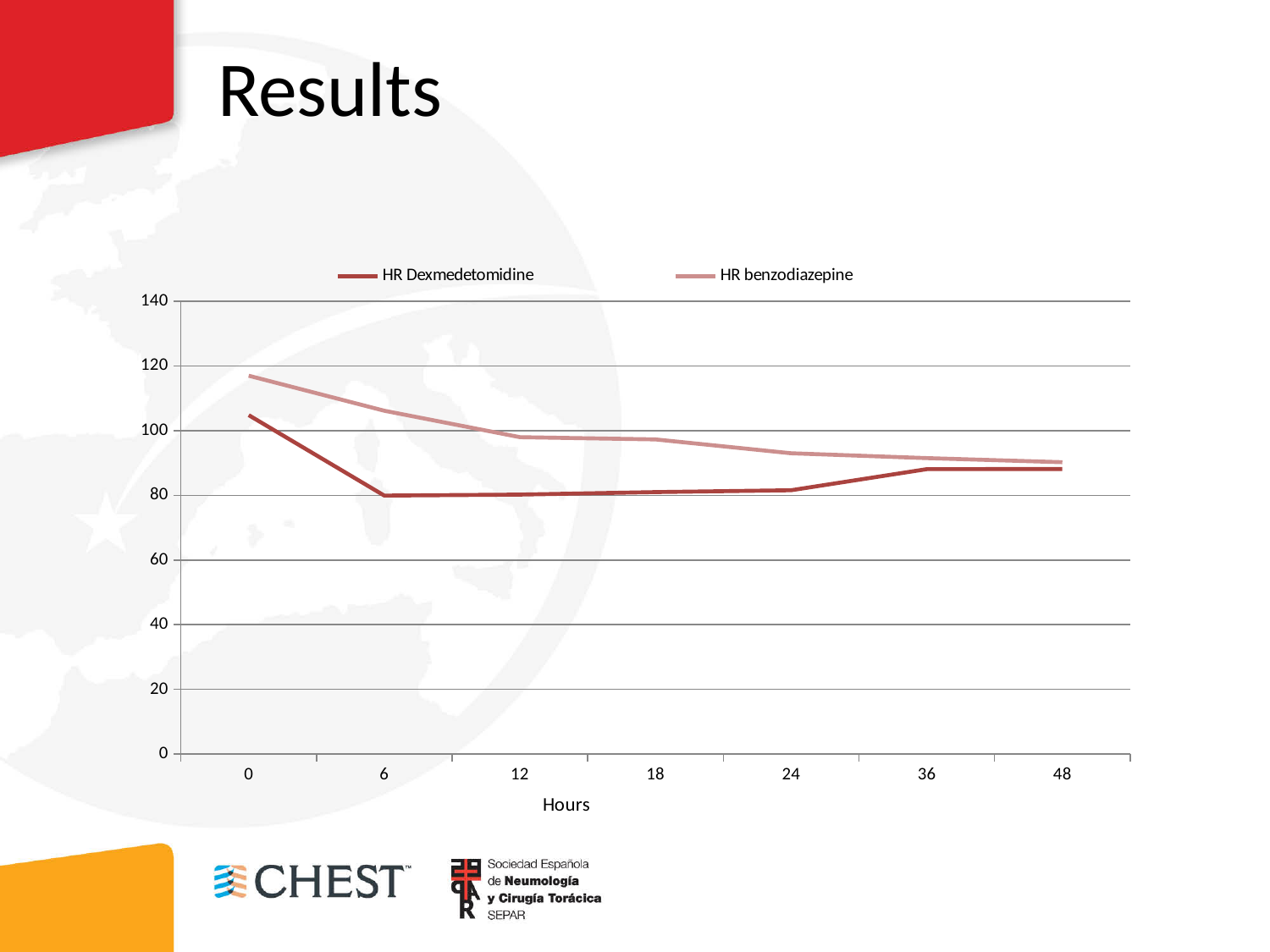
How many time points are plotted along the x axis? 7 Is the value for HR benzodiazepine at 6 hours greater or less than 100? greater Is the value for HR benzodiazepine at 24 hours greater or less than 100? less What is the title of the x axis? Hours At which hour does HR benzodiazepine reach its highest value? 0 How many series does the legend list? 2 Which series is drawn in the lighter pink line? HR benzodiazepine At 0 hours, which series has the higher value, HR Dexmedetomidine or HR benzodiazepine? HR benzodiazepine Is the value for HR Dexmedetomidine at 6 hours greater or less than 100? less Does the HR benzodiazepine line rise or fall from 0 to 48 hours? fall What kind of chart is shown on the slide? line chart